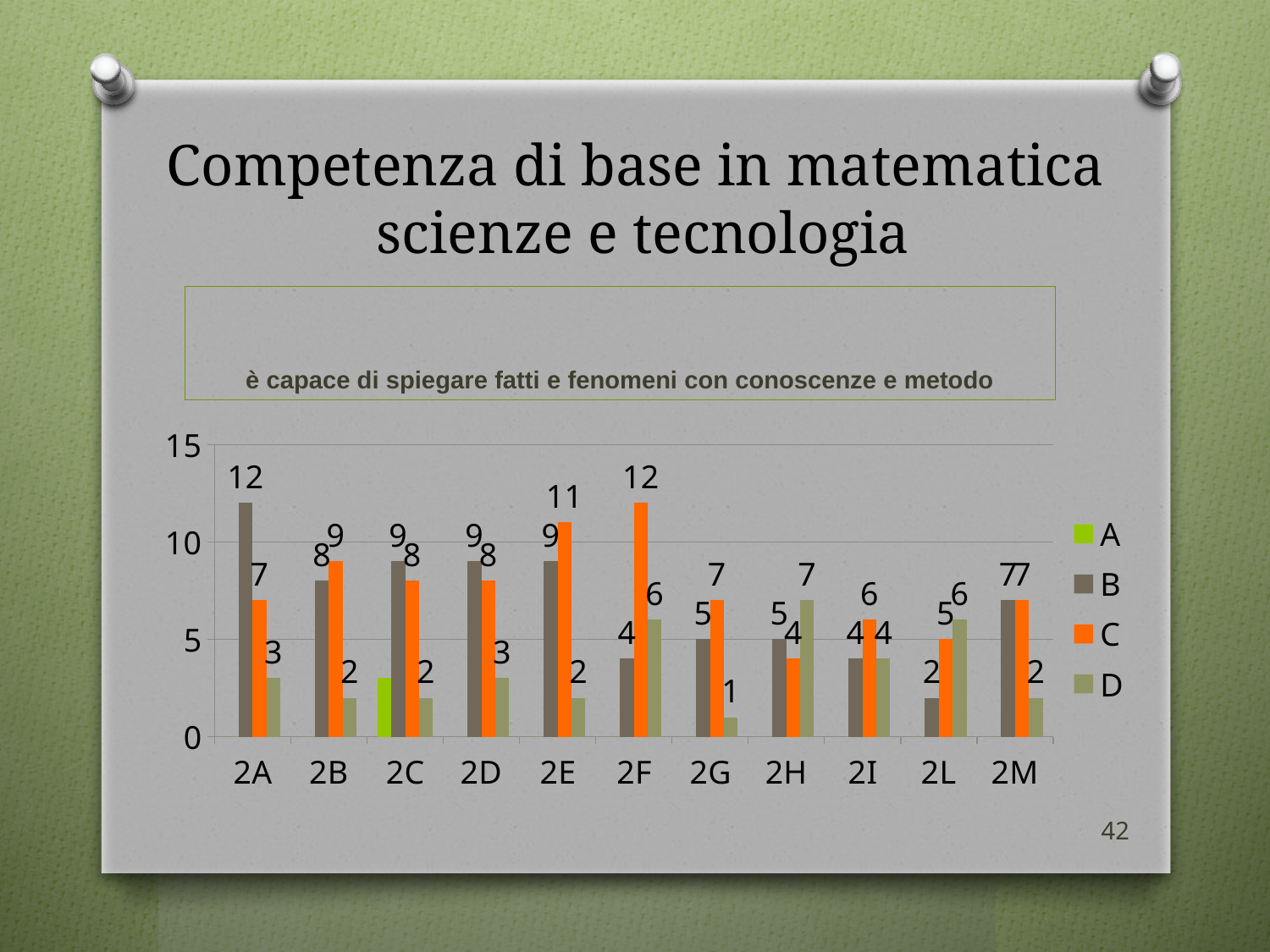
What is the difference between series B and series C for class 2A? 5 For class 2H, which is larger: series C or series D? D What is the value of series C for class 2F? 12 Is the value of series A for class 2C greater or less than 5? less Which class has the highest value for series C? 2F How many classes (categories) are shown on the x axis? 11 What is the value of series B for class 2A? 12 Which class has the highest value for series B? 2A What is the value of series D for class 2L? 6 Which class has the lowest value for series D? 2G What kind of chart is shown on the slide? bar chart How many series does the legend list? 4